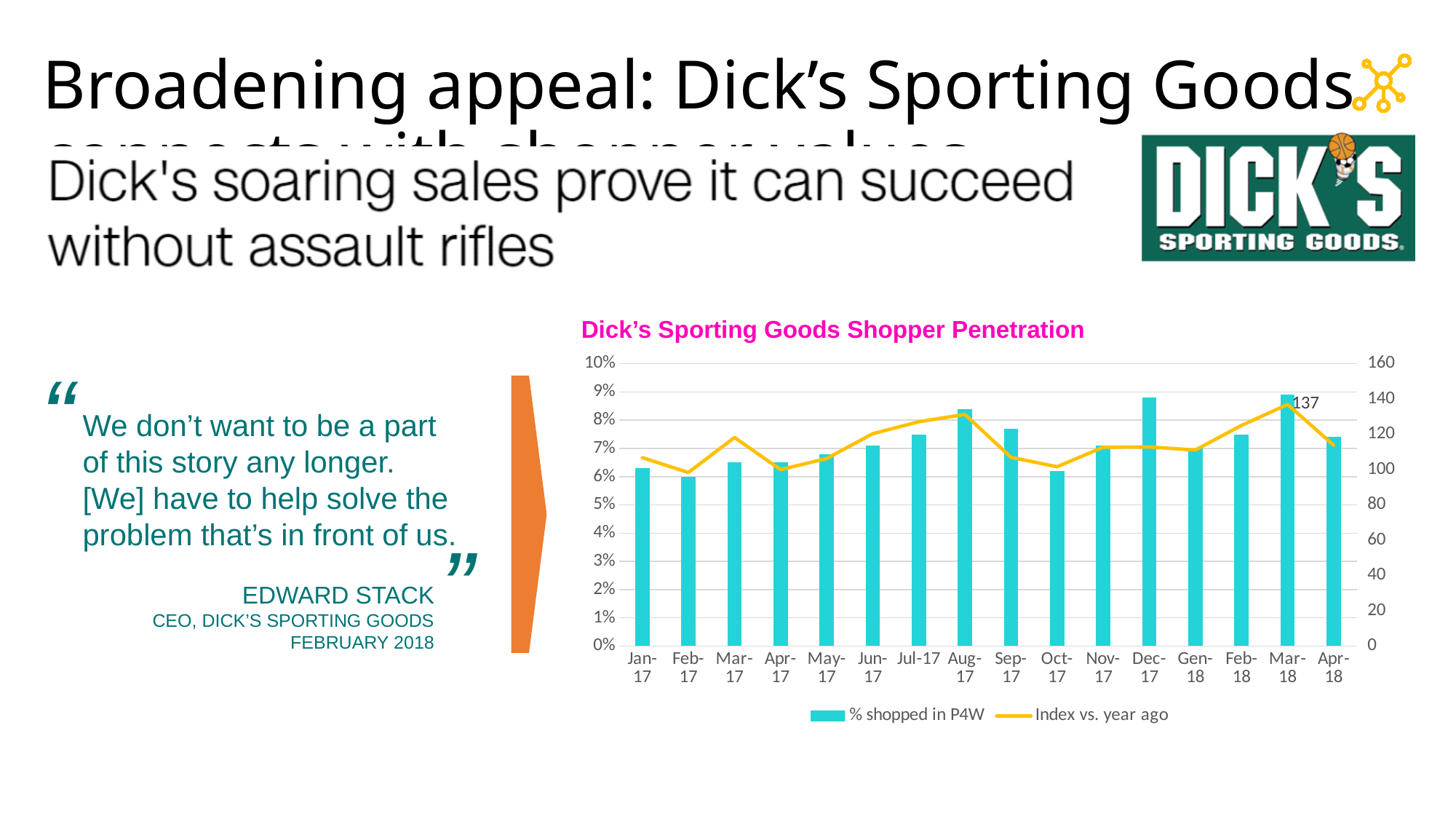
Is the % shopped in P4W bar for Dec-17 greater or less than 8%? greater How many series does the legend of the Shopper Penetration chart list? 2 What colour are the % shopped in P4W bars in the Shopper Penetration chart? Turquoise (cyan) Is the Index vs. year ago value for Oct-17 greater or less than 120? less In which month does the Index vs. year ago line reach its highest point? Mar-18 What kind of chart is shown under the title 'Dick's Sporting Goods Shopper Penetration'? A combined bar and line chart How many months are plotted along the x axis of the Shopper Penetration chart? 16 Which has the larger % shopped in P4W bar, Jul-17 or Feb-17? Jul-17 Does the Index vs. year ago line rise or fall from Mar-18 to Apr-18? fall Which has the larger % shopped in P4W bar, Dec-17 or Jan-17? Dec-17 What is the value of the Index vs. year ago line for Mar-18? 137 Is the % shopped in P4W bar for Jan-17 greater or less than 7%? less